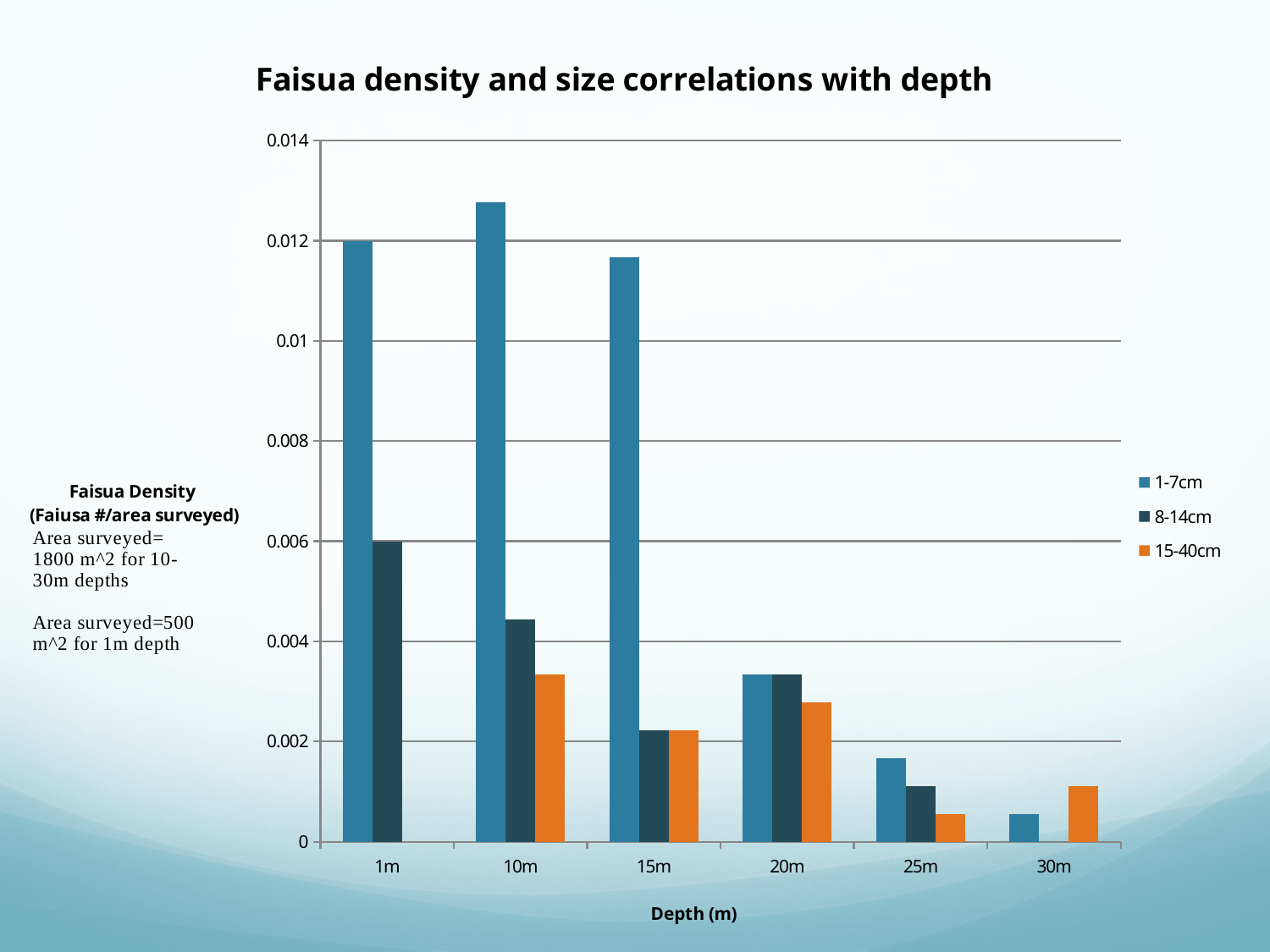
What is the title of the x axis? Depth (m) Is the value for 15-40cm at 20m greater or less than 0.002? greater How many series does the legend list? 3 At which depth is the 1-7cm bar the lowest? 30m Does the 1-7cm series rise or fall from 15m to 30m? fall Is the value for 8-14cm at 10m greater or less than 0.004? greater At 25m, which series has the larger value, 1-7cm or 8-14cm? 1-7cm At which depth is the 1-7cm bar the highest? 10m Is the value for 1-7cm at 15m greater or less than 0.01? greater What kind of chart is shown on the slide? bar chart How many depth categories are shown on the x axis? 6 At 30m, which series has the larger value, 1-7cm or 15-40cm? 15-40cm